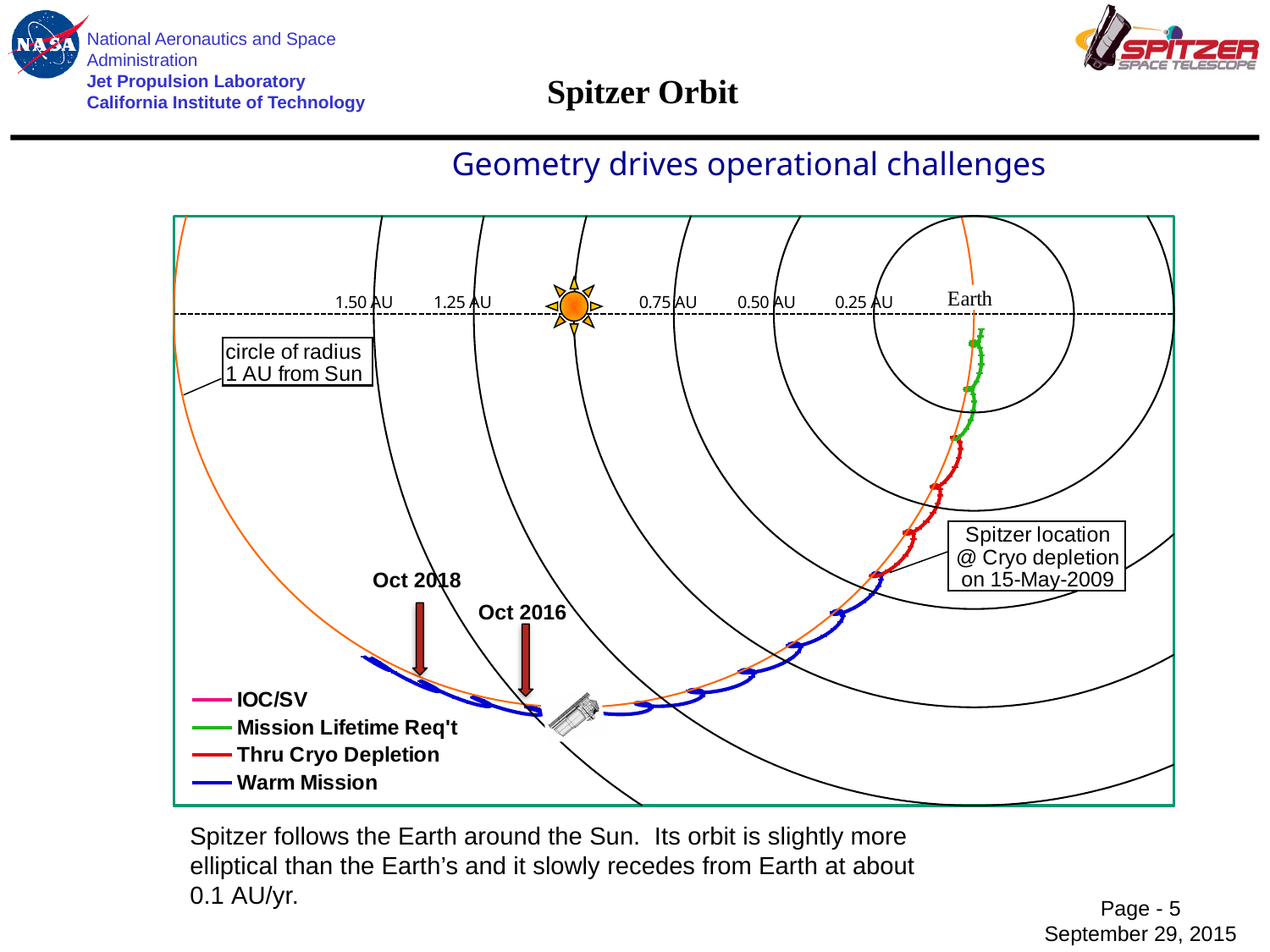
Which legend entry is listed first in the diagram's legend? IOC/SV How many entries does the legend of the orbit diagram list? 4 Which legend entry is listed immediately after Mission Lifetime Req't? Thru Cryo Depletion What is the smallest distance value labeled on the concentric rings in the diagram? 0.25 AU What is the radius of the orange circle centred on the Sun, according to the label on the diagram? 1 AU from Sun Which legend entry is drawn in blue? Warm Mission According to the annotation on the diagram, on what date was Spitzer at the marked cryo depletion location? 15-May-2009 Which two dates are marked with arrows along the Warm Mission portion of the orbit? Oct 2016 and Oct 2018 How many distance labels in AU are printed along the dashed line in the diagram? 5 What is the subtitle printed above the orbit diagram? Geometry drives operational challenges What is the largest distance value labeled on the concentric rings in the diagram? 1.50 AU